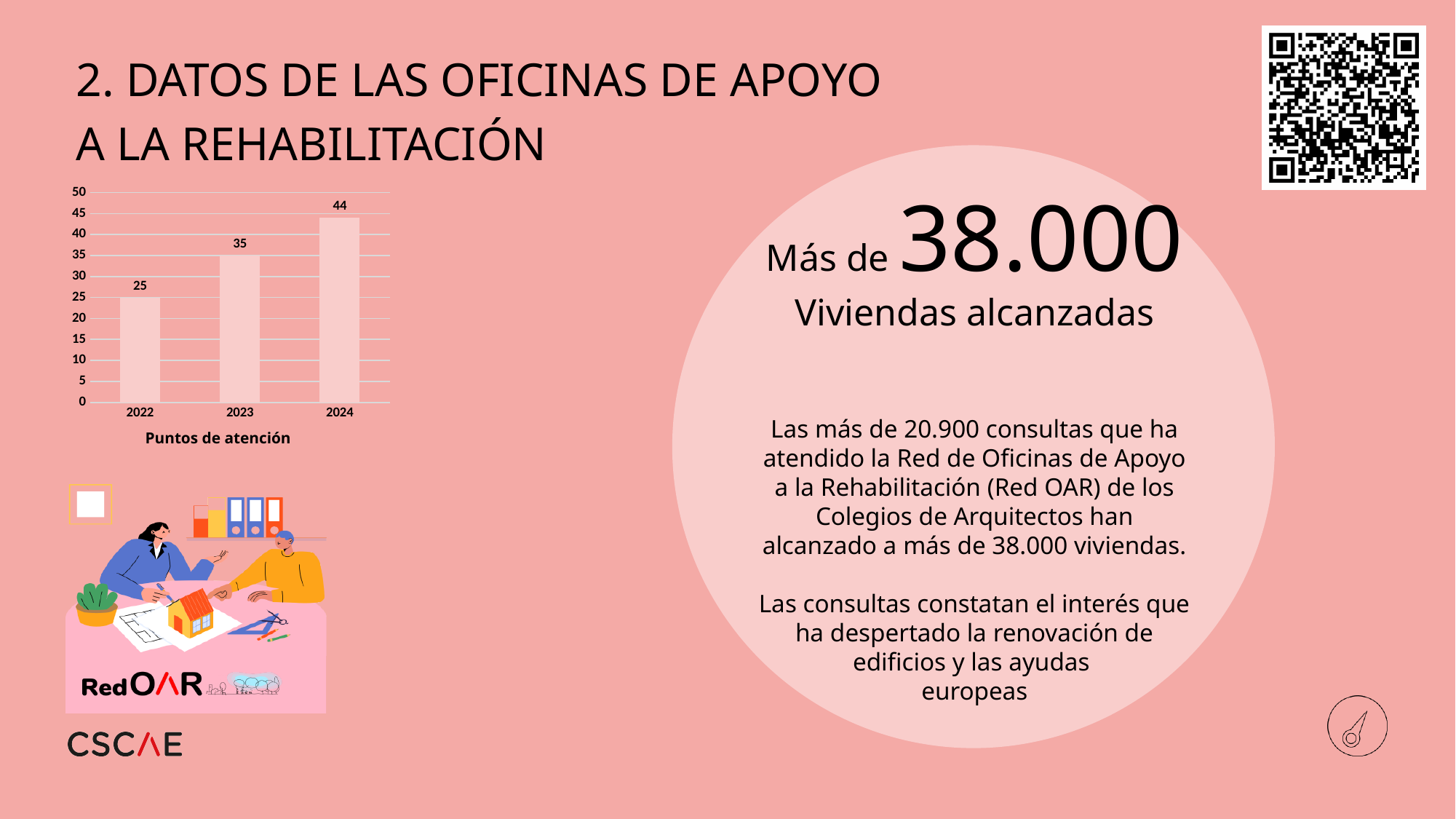
Do the values in the Puntos de atención chart rise or fall from 2022 to 2024? rise Which is larger in the Puntos de atención chart, the value for 2023 or the value for 2024? 2024 What is the value for 2024 in the Puntos de atención chart? 44 Is the value for 2024 in the Puntos de atención chart greater or less than 40? greater How many years are shown on the x axis of the Puntos de atención chart? 3 Which year has the lowest value in the Puntos de atención chart? 2022 What is the value for 2023 in the Puntos de atención chart? 35 Which year has the highest value in the Puntos de atención chart? 2024 What is the difference between the 2023 and 2022 values in the Puntos de atención chart? 10 What is the value for 2022 in the Puntos de atención chart? 25 What is the difference between the 2024 and 2022 values in the Puntos de atención chart? 19 What kind of chart is the Puntos de atención chart? bar chart